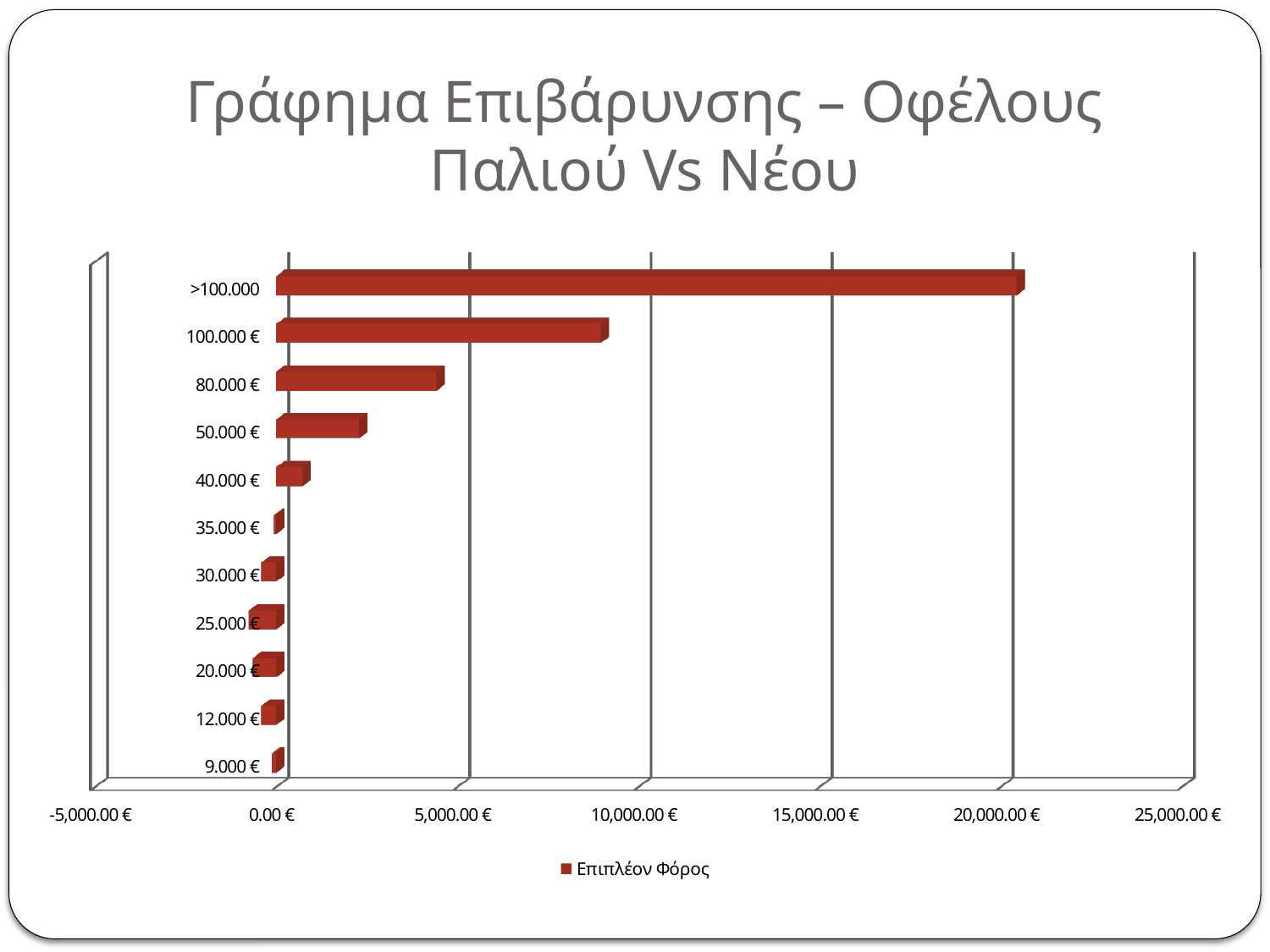
What is the name of the series shown in the legend? Επιπλέον Φόρος Is the value for 80.000 € greater or less than 5,000.00 €? less Which is larger, the value for 50.000 € or the value for 40.000 €? 50.000 € Is the value for >100.000 greater or less than 15,000.00 €? greater Is the value for 100.000 € greater or less than 5,000.00 €? greater What kind of chart is shown on the slide? bar chart How many categories are shown on the chart? 11 How many series does the legend list? 1 Which is larger, the value for 100.000 € or the value for 80.000 €? 100.000 € Which category has the highest value? >100.000